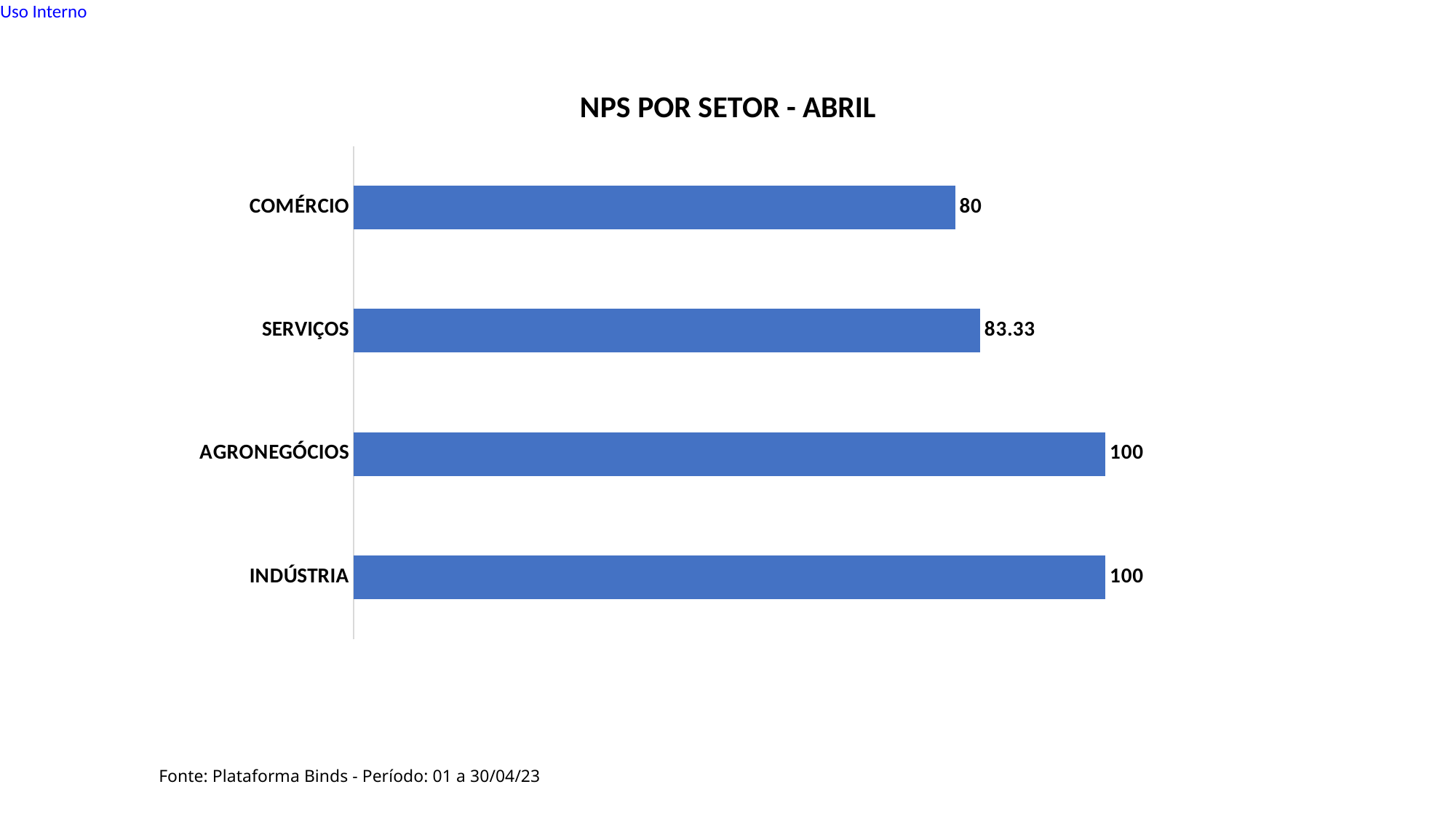
What is the difference between the NPS of SERVIÇOS and COMÉRCIO? 3.33 What is the source cited below the chart? Plataforma Binds - Período: 01 a 30/04/23 Which sector has the lowest NPS? COMÉRCIO What kind of chart is shown on the slide? Bar chart What is the NPS value for INDÚSTRIA? 100 What is the title of the chart? NPS POR SETOR - ABRIL What is the NPS value for AGRONEGÓCIOS? 100 How many sectors are shown in the chart? 4 What is the difference between the NPS of INDÚSTRIA and SERVIÇOS? 16.67 What is the NPS value for SERVIÇOS? 83.33 What is the NPS value for COMÉRCIO? 80 Which has a higher NPS, SERVIÇOS or COMÉRCIO? SERVIÇOS